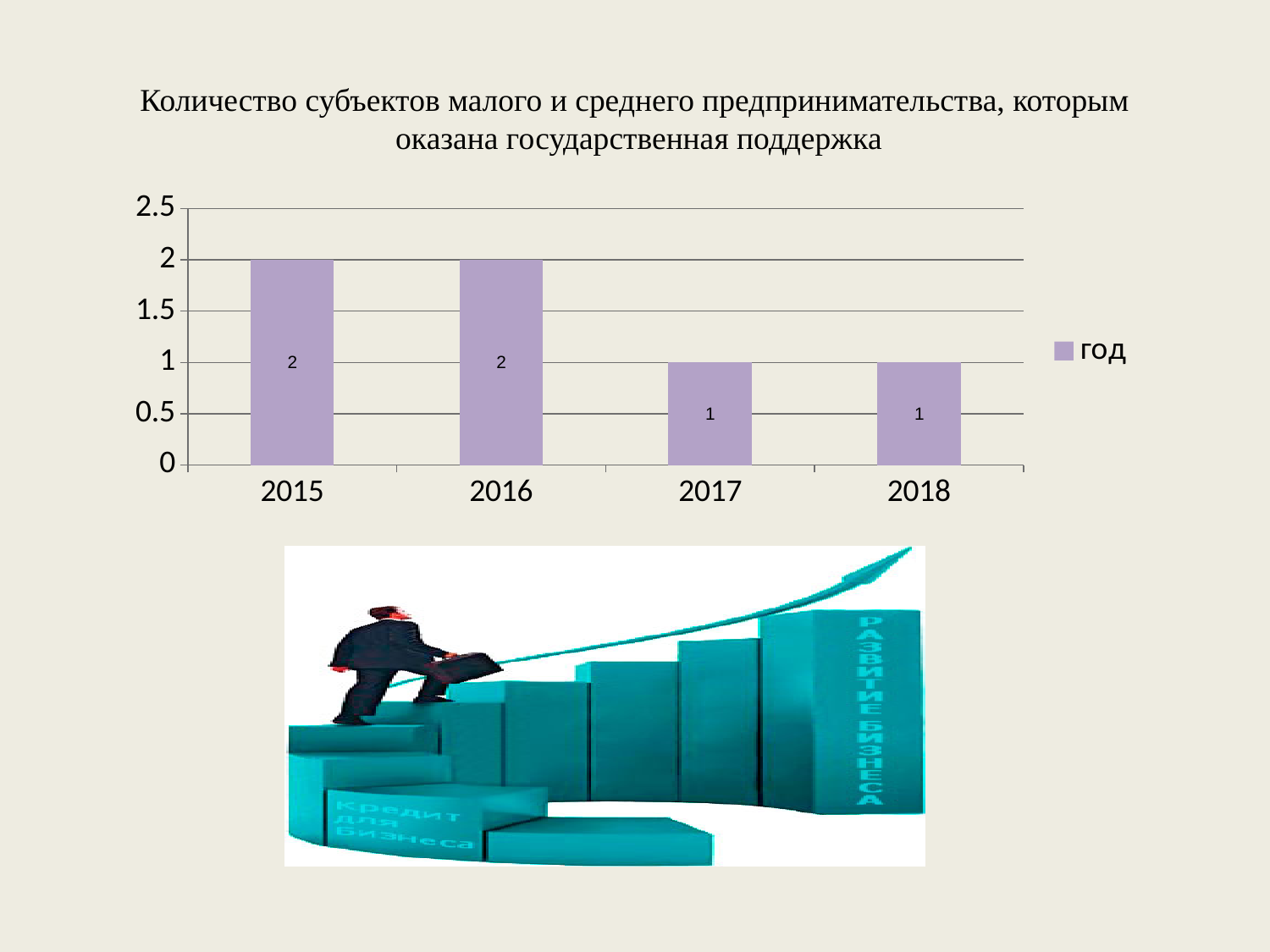
What kind of chart is shown on the slide? bar chart What is the difference between the values for 2016 and 2017? 1 Is the value for 2016 greater or less than 1.5? greater How many years are shown on the x axis? 4 What is the legend entry for the series? год What is the value for 2015? 2 Do the values rise or fall from 2015 to 2018? fall How many series does the legend list? 1 What is the value for 2016? 2 Which is larger, the value for 2015 or the value for 2018? 2015 What is the value for 2018? 1 What is the value for 2017? 1